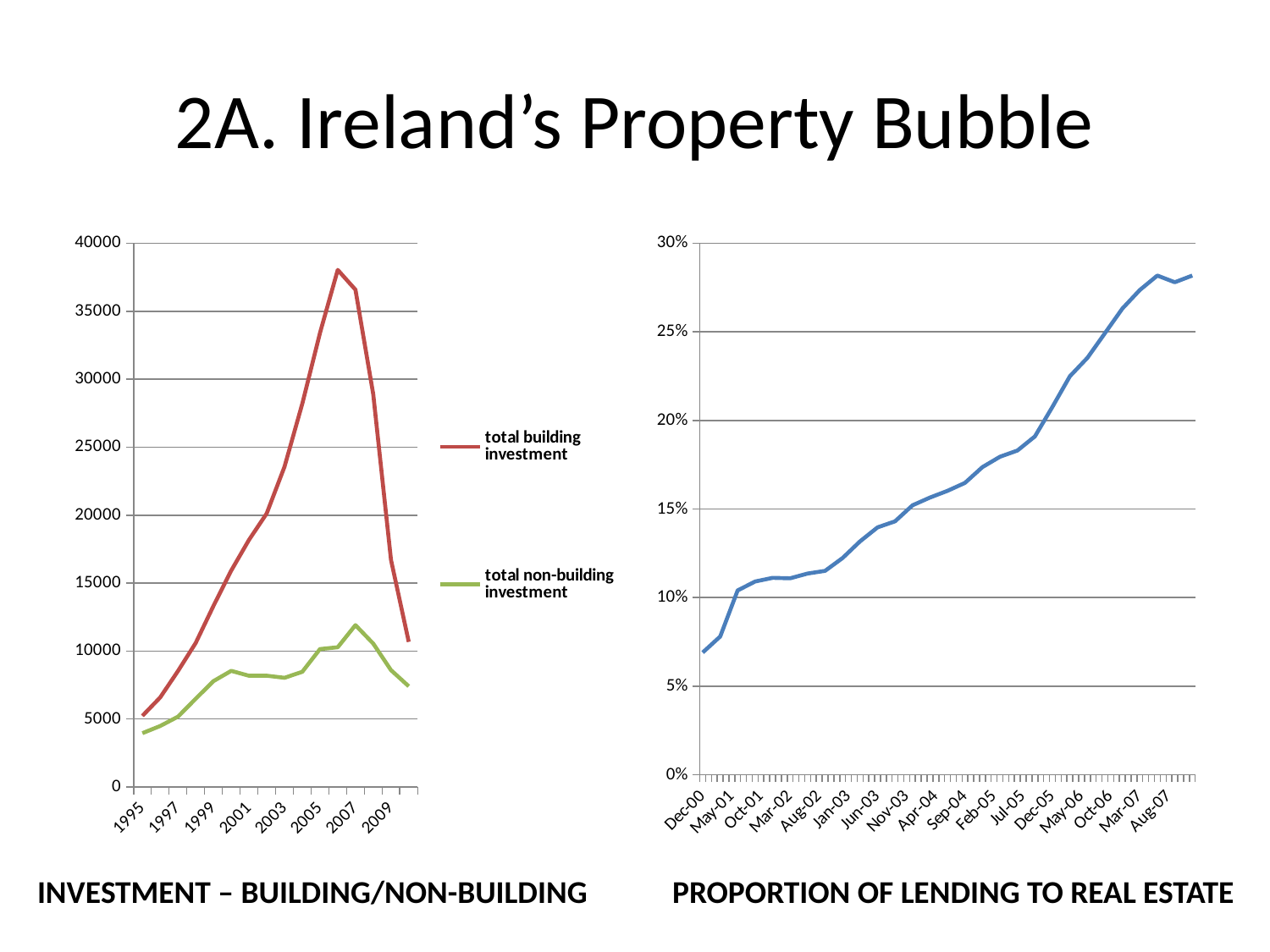
In the left chart, 'Investment – Building/Non-Building', is the peak value of total non-building investment greater or less than 15000? less In the left chart, 'Investment – Building/Non-Building', which series reaches the higher peak value? total building investment In the left chart, 'Investment – Building/Non-Building', in which year does total building investment reach its highest value? 2006 In the left chart, 'Investment – Building/Non-Building', what colour is the line for total non-building investment? green In the right chart, 'Proportion of Lending to Real Estate', is the value for Dec-00 greater or less than 10%? less What kind of chart is the right chart, 'Proportion of Lending to Real Estate'? line chart How many series does the legend of the left chart, 'Investment – Building/Non-Building', list? 2 What kind of chart is the left chart, 'Investment – Building/Non-Building'? line chart In the left chart, 'Investment – Building/Non-Building', is the value for total building investment in 1995 greater or less than 10000? less In the right chart, 'Proportion of Lending to Real Estate', do the values generally rise or fall from Dec-00 to Aug-07? rise